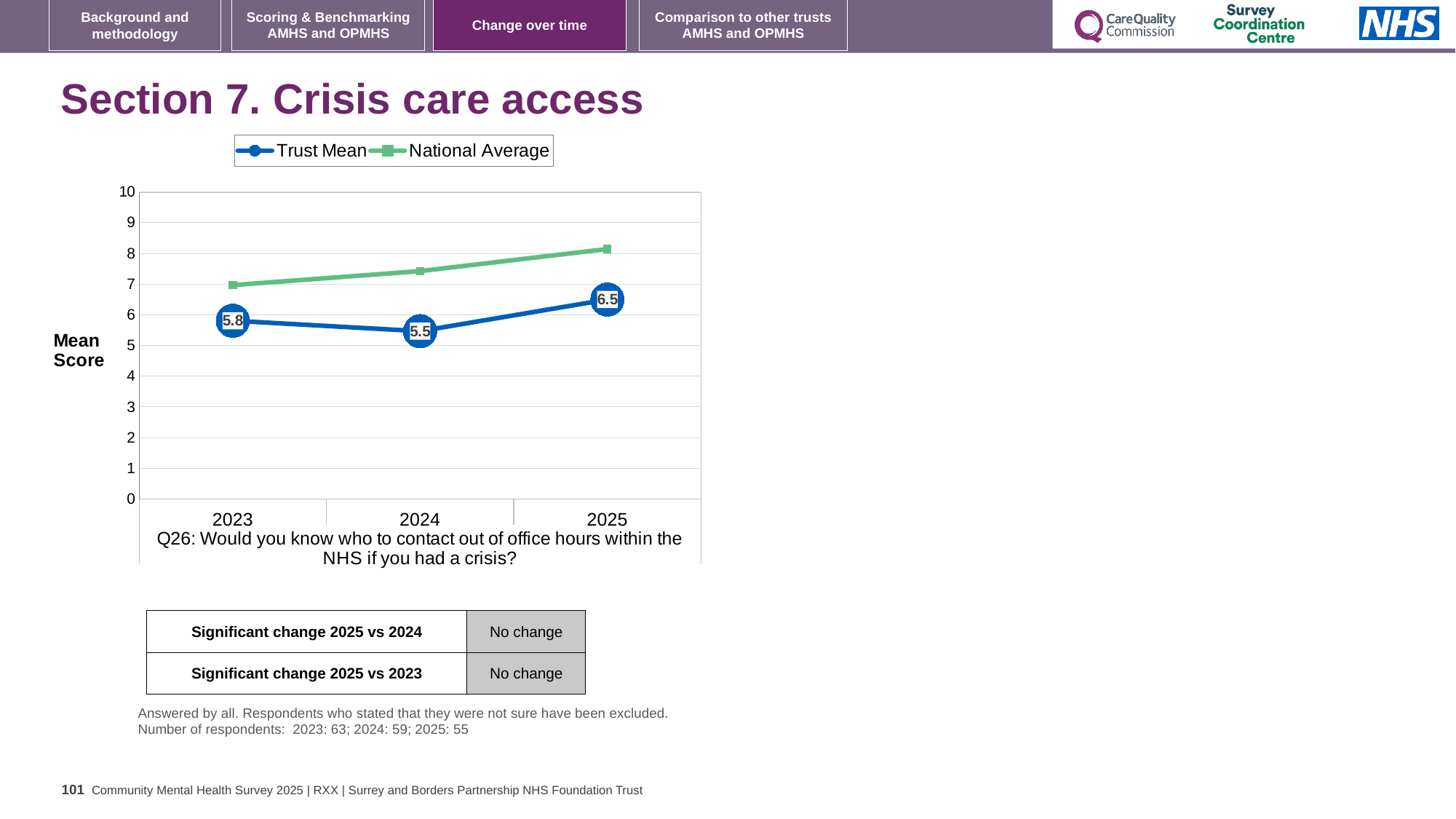
In 2025, which series has the higher value, Trust Mean or National Average? National Average Which is larger, the Trust Mean score for 2023 or for 2024? 2023 In which year is the Trust Mean score lowest? 2024 What is the difference between the Trust Mean scores for 2025 and 2024? 1.0 Is the National Average value for 2024 greater or less than 7? greater What kind of chart is shown on the slide? line chart In which year is the Trust Mean score highest? 2025 What is the Trust Mean score for 2024? 5.5 What is the Trust Mean score for 2023? 5.8 How many years are plotted on the x axis? 3 How many series does the legend list? 2 What is the Trust Mean score for 2025? 6.5